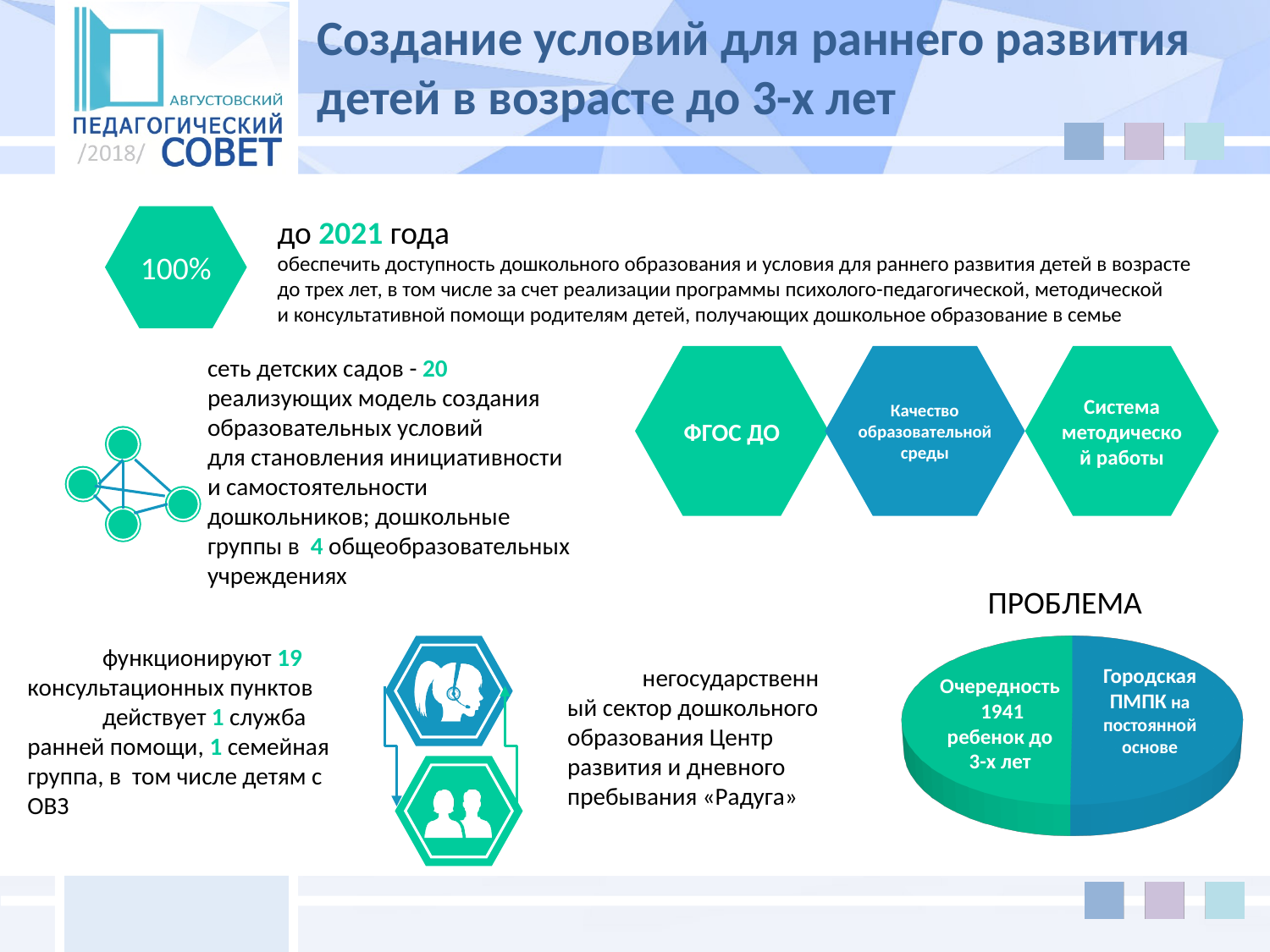
What kind of chart is shown under the heading ПРОБЛЕМА? pie chart According to the label on the green slice of the pie chart, how many children under 3 are on the waiting list (Очередность)? 1941 What colour is the slice labelled 'Городская ПМПК на постоянной основе' in the pie chart? blue What heading appears above the pie chart? ПРОБЛЕМА How many slices does the pie chart under ПРОБЛЕМА have? 2